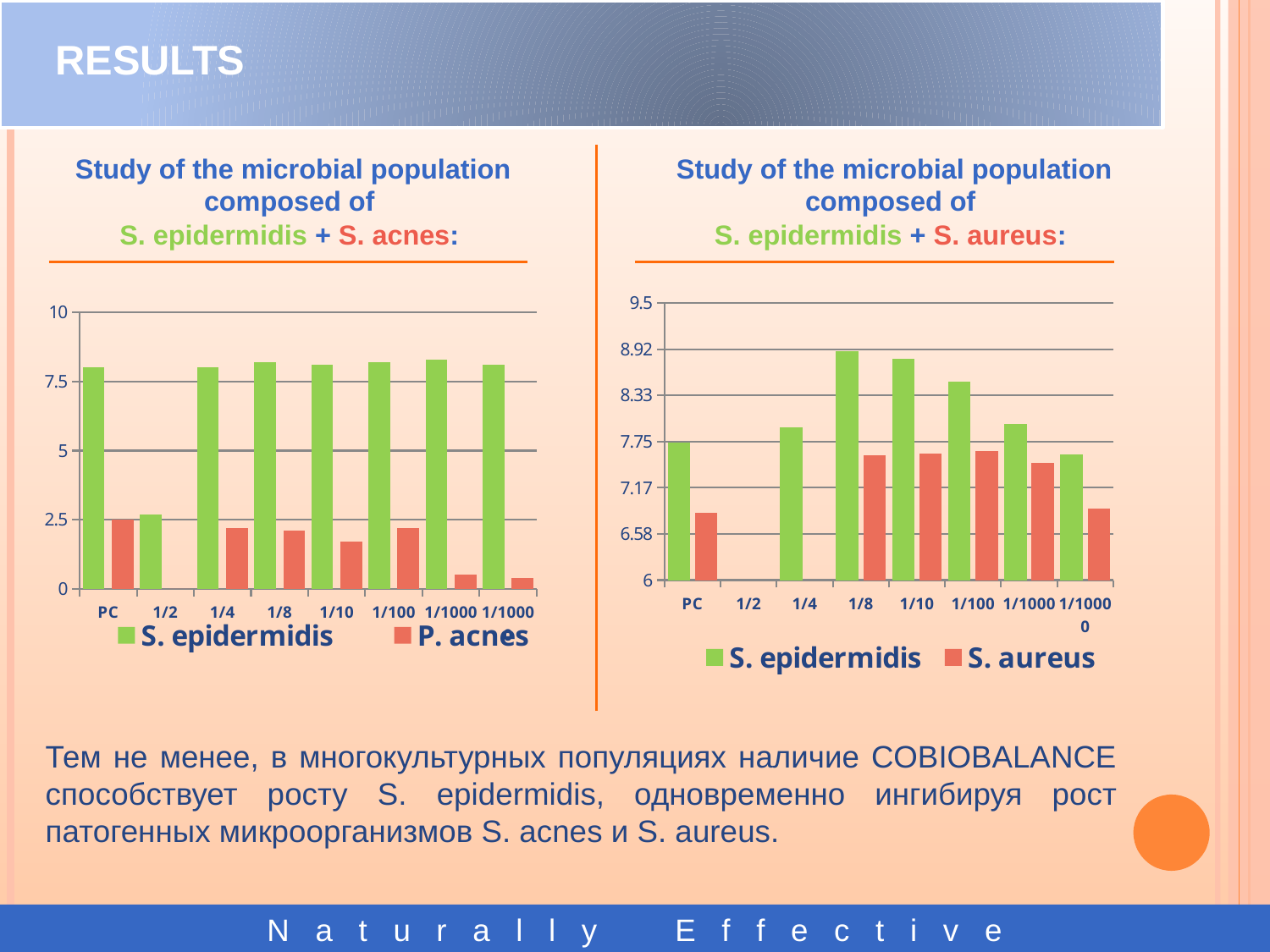
How many series does the legend of the right chart (S. epidermidis + S. aureus) list? 2 What kind of chart is the left chart, 'Study of the microbial population composed of S. epidermidis + S. acnes'? Bar chart How many categories are shown on the x axis of the left chart (S. epidermidis + S. acnes)? 8 In the left chart (S. epidermidis + S. acnes), is the value of P. acnes at 1/10000 greater or less than 2.5? less What are the two legend entries of the left chart (S. epidermidis + S. acnes)? S. epidermidis and P. acnes In the right chart (S. epidermidis + S. aureus), is the value of S. epidermidis at 1/8 greater or less than 8.33? greater In the left chart (S. epidermidis + S. acnes), which series has the larger value at PC, S. epidermidis or P. acnes? S. epidermidis In the left chart (S. epidermidis + S. acnes), at which category is S. epidermidis lowest? 1/2 In the right chart (S. epidermidis + S. aureus), is the value of S. aureus at PC greater or less than 7.17? less In the right chart (S. epidermidis + S. aureus), do the S. epidermidis values rise or fall from 1/8 to 1/10000? fall